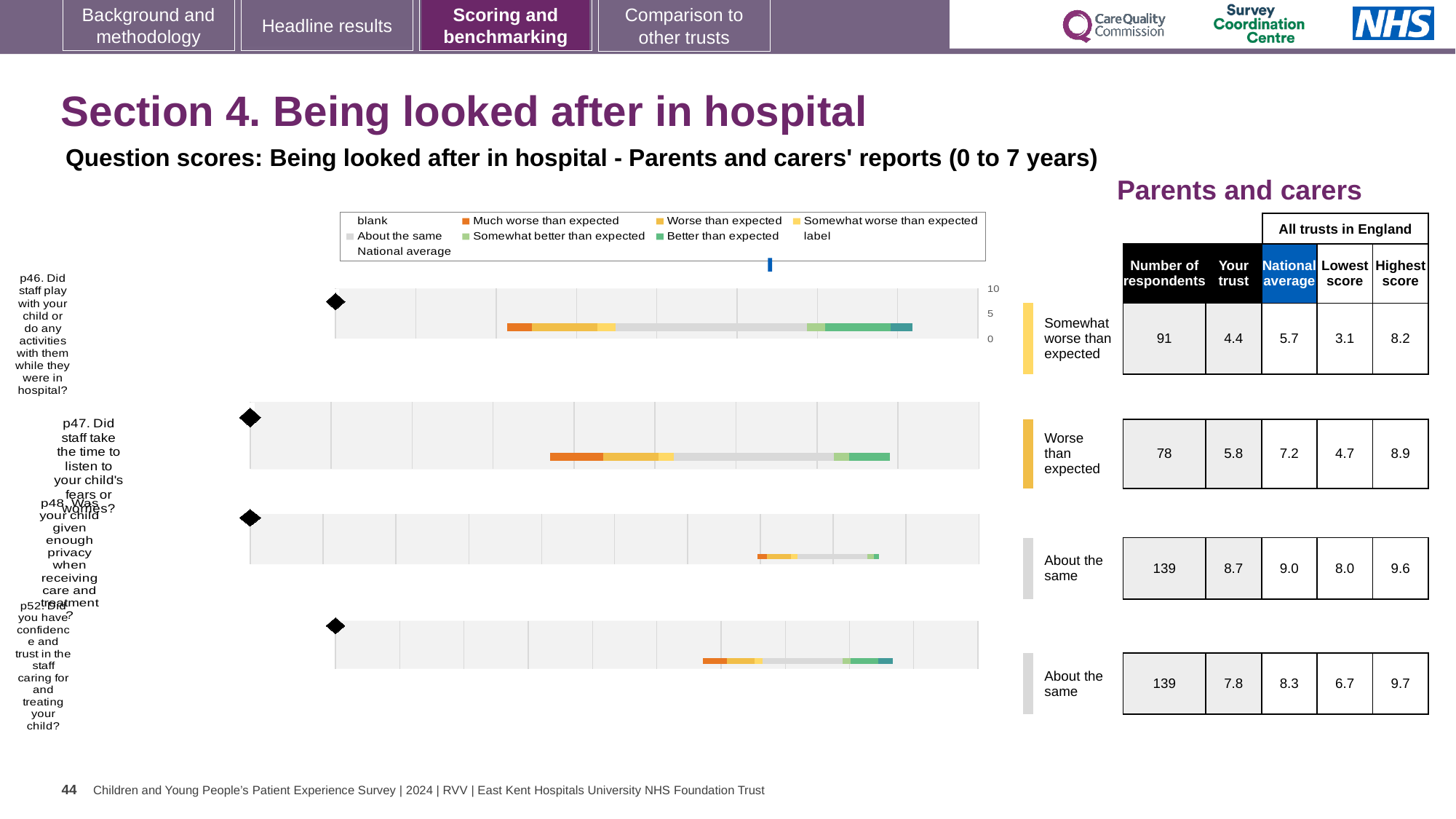
According to the table beside the chart for p46 (Did staff play with your child or do any activities with them while they were in hospital?), what is the 'Your trust' score? 4.4 What is the difference between the national average and the 'Your trust' score for p46 in the table beside the chart? 1.3 Which of the four questions has the highest 'Your trust' score in the table beside the charts? p48. Was your child given enough privacy when receiving care and treatment? According to the table beside the chart for p47 (Did staff take the time to listen to your child's fears or worries?), what is the national average score? 7.2 What kind of chart is used for each question on the slide? bar chart In the chart legend, which colour represents 'Much worse than expected'? orange What benchmark category label is shown beside the chart for p47 (Did staff take the time to listen to your child's fears or worries?)? Worse than expected How many separate charts are plotted on the slide? 4 Which of the four questions has the lowest 'Your trust' score in the table beside the charts? p46. Did staff play with your child or do any activities with them while they were in hospital? According to the table beside the chart for p52 (Did you have confidence and trust in the staff caring for and treating your child?), how many respondents were there? 139 According to the table beside the chart for p48 (Was your child given enough privacy when receiving care and treatment?), what is the highest score among all trusts in England? 9.6 What is the highest value shown on the vertical axis of the first chart (p46)? 10